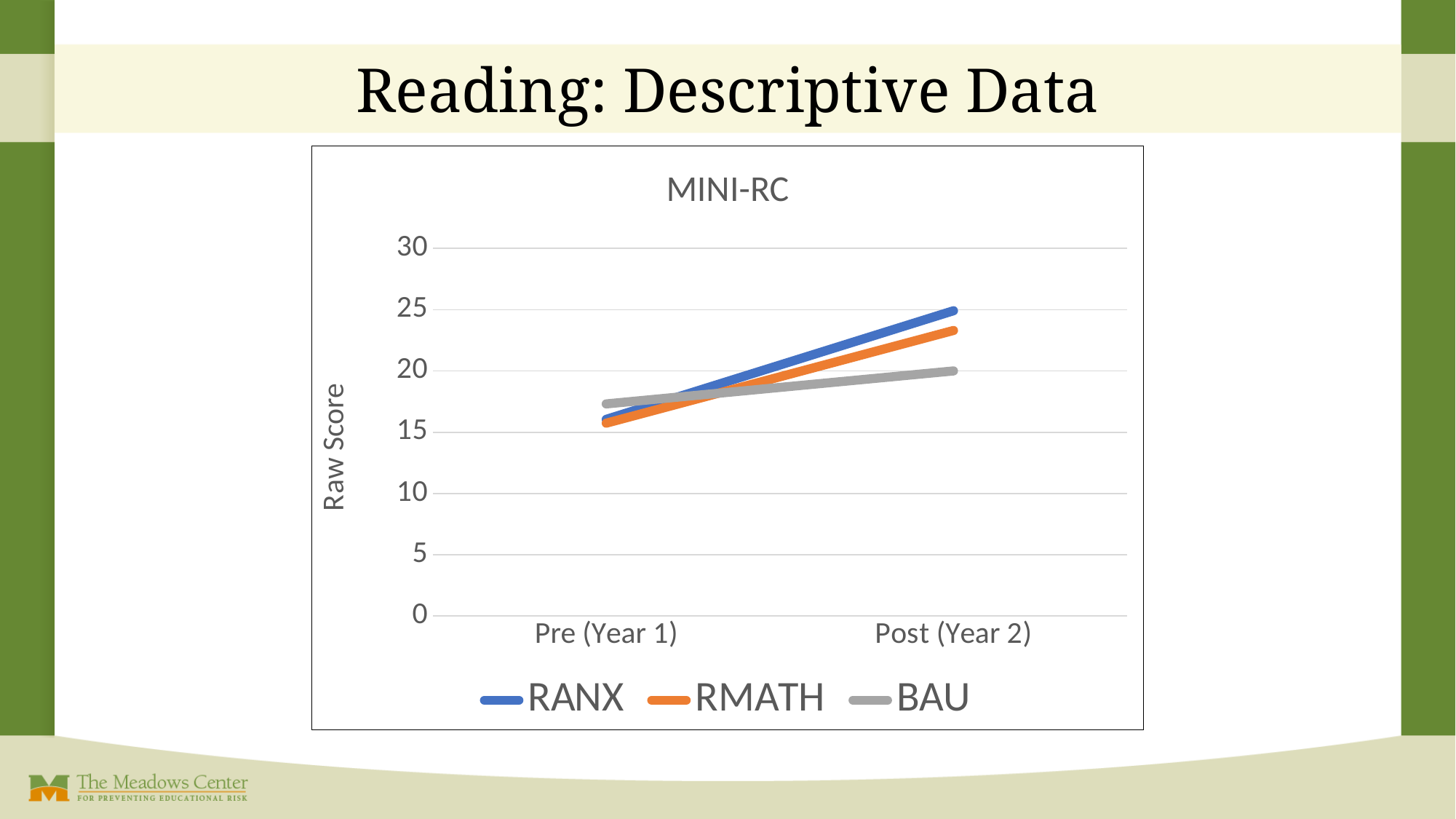
What kind of chart is shown on the slide? line chart How many categories are shown on the x axis? 2 Does the RANX series rise or fall from Pre (Year 1) to Post (Year 2)? rise Which series has the highest value at Post (Year 2)? RANX Which series has the lowest value at Post (Year 2)? BAU Is the value for BAU at Pre (Year 1) greater or less than 15? greater At Post (Year 2), which is larger, RANX or BAU? RANX What is the title of the chart? MINI-RC Is the value for RMATH at Pre (Year 1) greater or less than 20? less Is the value for RANX at Post (Year 2) greater or less than 20? greater What is the label of the y axis? Raw Score How many series does the legend list? 3